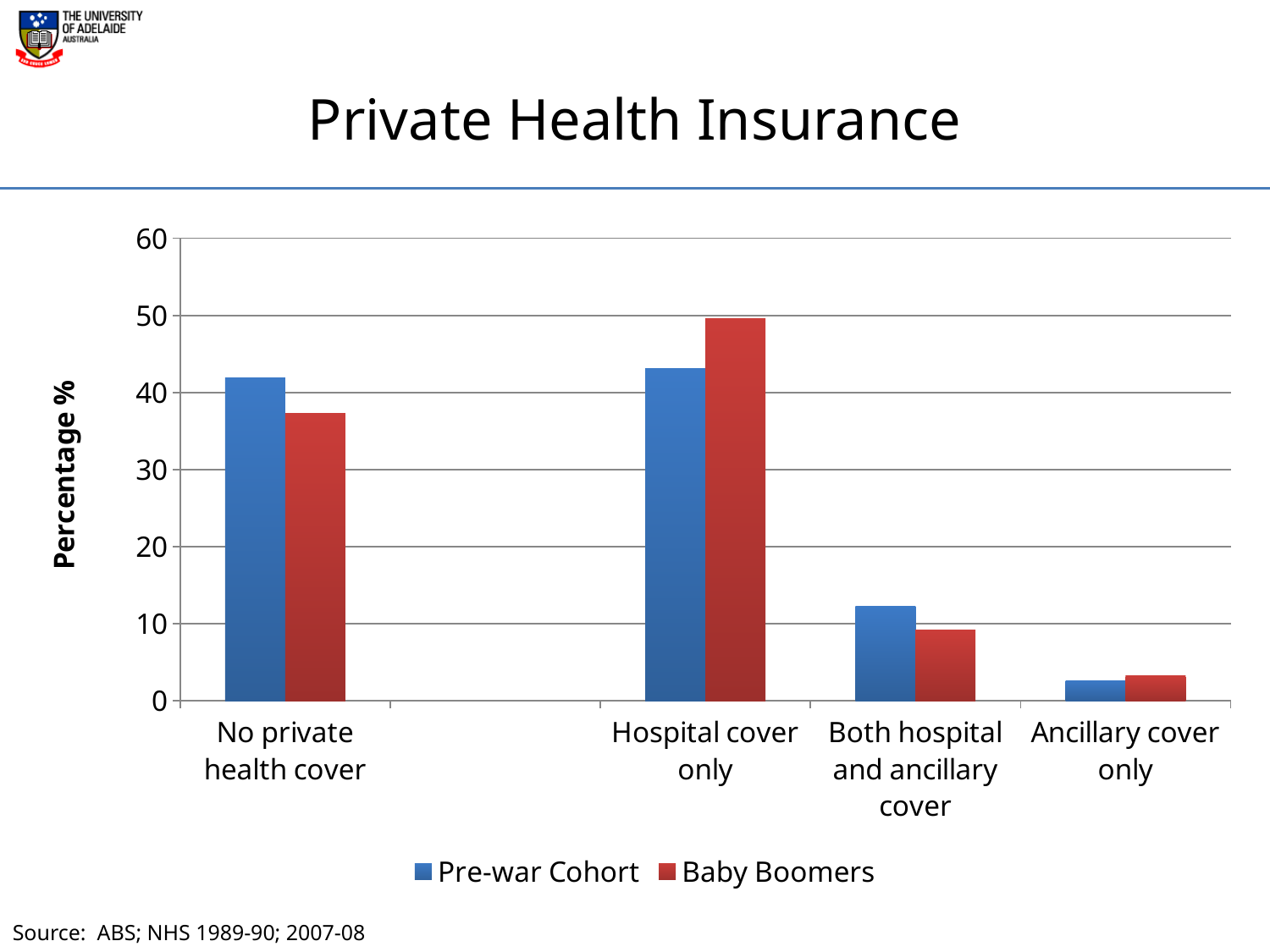
Is the Pre-war Cohort value for Both hospital and ancillary cover greater or less than 20? less Is the Baby Boomers value for Hospital cover only greater or less than 40? greater How many series does the legend list? 2 For Hospital cover only, which series has the larger value, Pre-war Cohort or Baby Boomers? Baby Boomers For the Baby Boomers series, which category has the highest value? Hospital cover only For the Pre-war Cohort series, which category has the lowest value? Ancillary cover only What is the title of the vertical axis? Percentage % What colour represents the Baby Boomers series? Red What kind of chart is shown on the slide? Bar chart For the Baby Boomers series, which category has the lowest value? Ancillary cover only How many category labels appear on the x axis? 4 For No private health cover, which series has the larger value, Pre-war Cohort or Baby Boomers? Pre-war Cohort